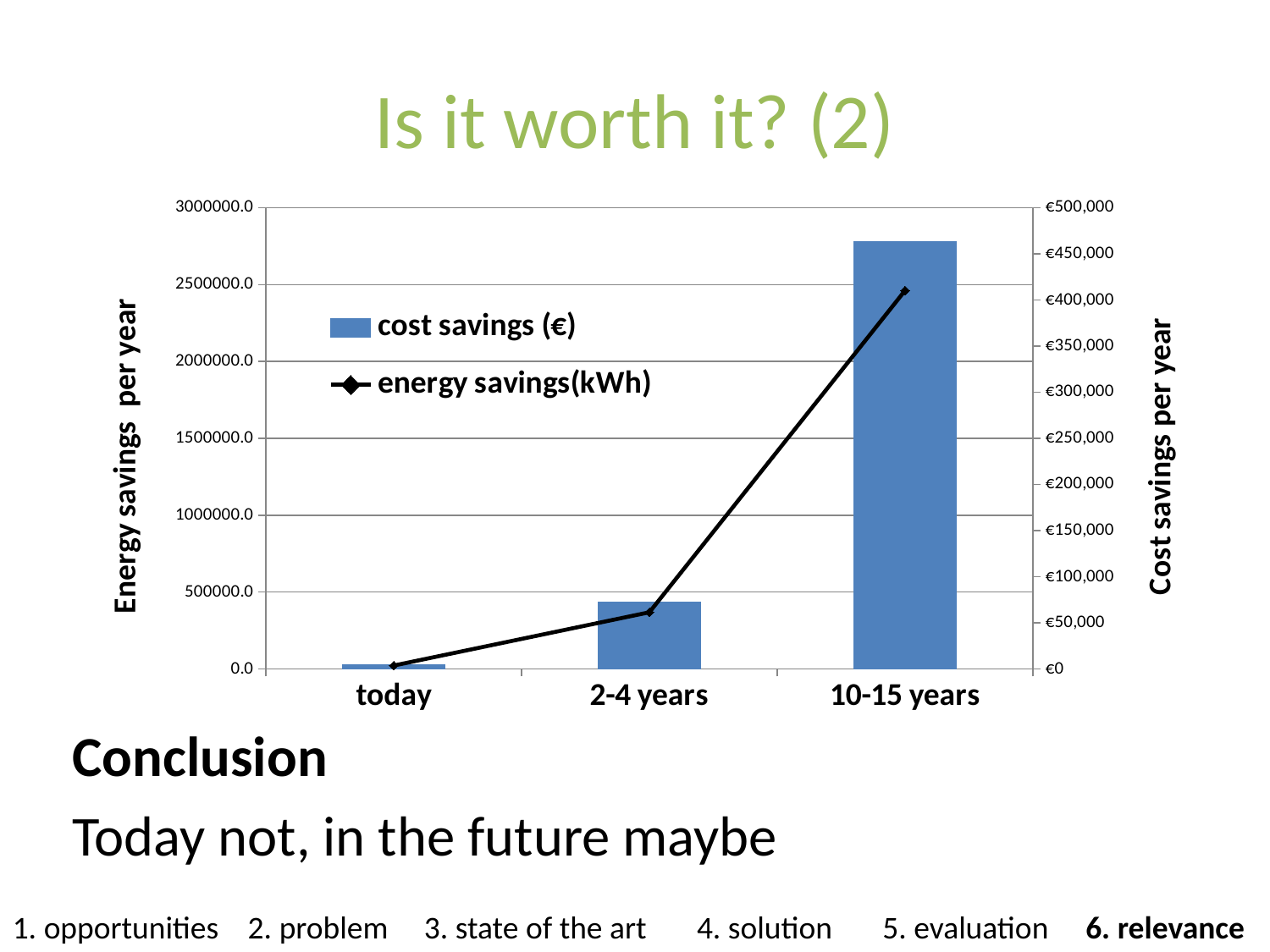
Which category has the highest cost savings (€)? 10-15 years How many categories are shown on the x axis of the chart? 3 Is the cost savings (€) value for 10-15 years greater or less than €400,000? greater How many series does the chart's legend list? 2 Which series is plotted as a line with diamond markers? energy savings(kWh) Is the cost savings (€) value for 2-4 years greater or less than €50,000? greater Do the energy savings (kWh) values rise or fall from today to 10-15 years? rise Which category has the lowest energy savings (kWh)? today Which is larger, the cost savings (€) for 2-4 years or for 10-15 years? 10-15 years Is the energy savings (kWh) value for 2-4 years greater or less than 500000.0? less What is the label of the right-hand vertical axis? Cost savings per year